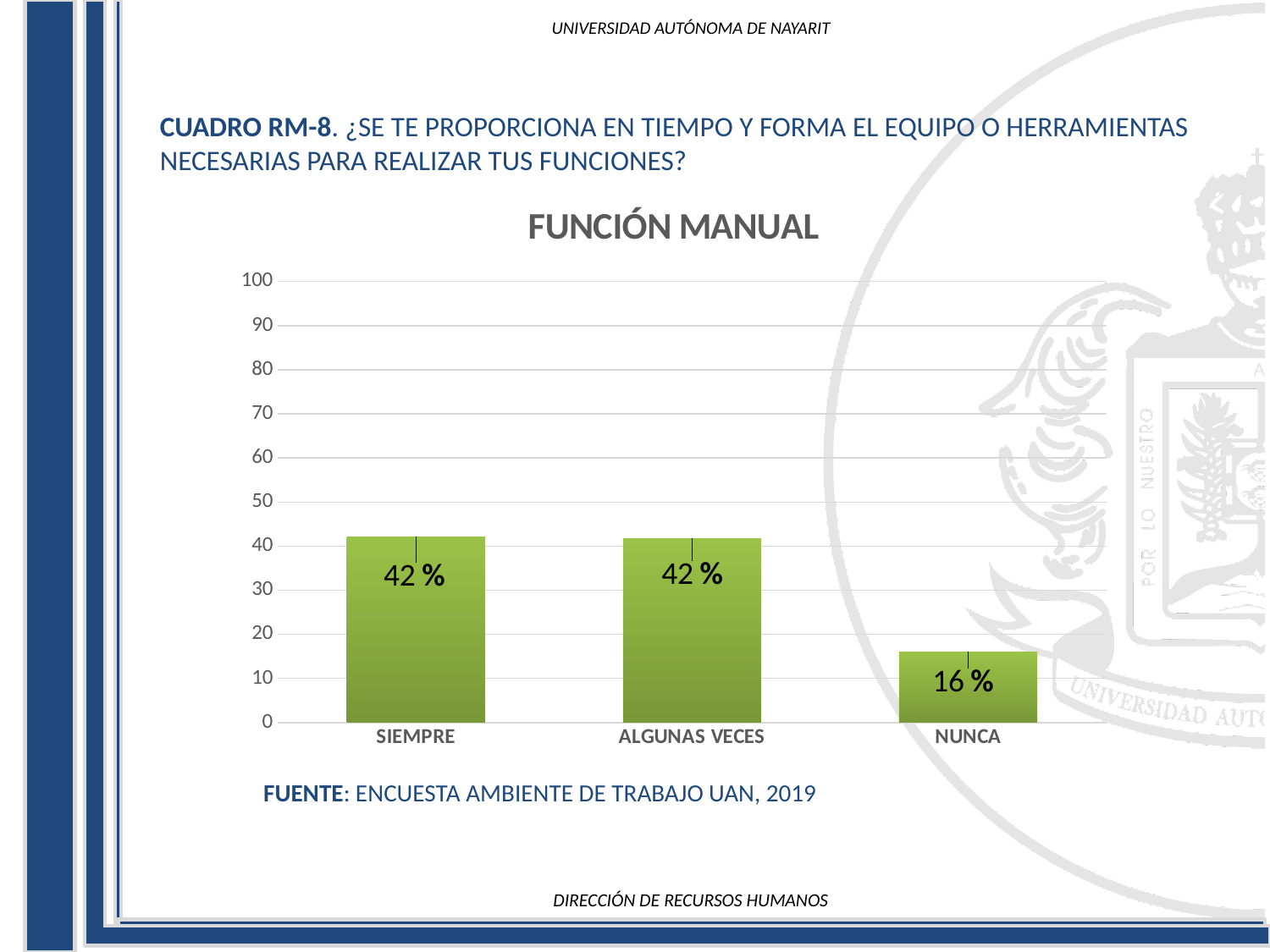
How many categories are shown on the x axis? 3 Which category has the lowest value? NUNCA What kind of chart is shown? bar chart What is the highest value shown on the y axis? 100 What is the value for SIEMPRE? 42 % Which is larger, the value for ALGUNAS VECES or the value for NUNCA? ALGUNAS VECES What is the value for ALGUNAS VECES? 42 % Is the value for SIEMPRE greater or less than 40? greater What is the difference between the values for SIEMPRE and NUNCA? 26 % Is the value for NUNCA greater or less than 20? less What is the value for NUNCA? 16 % What is the title of the chart? FUNCIÓN MANUAL